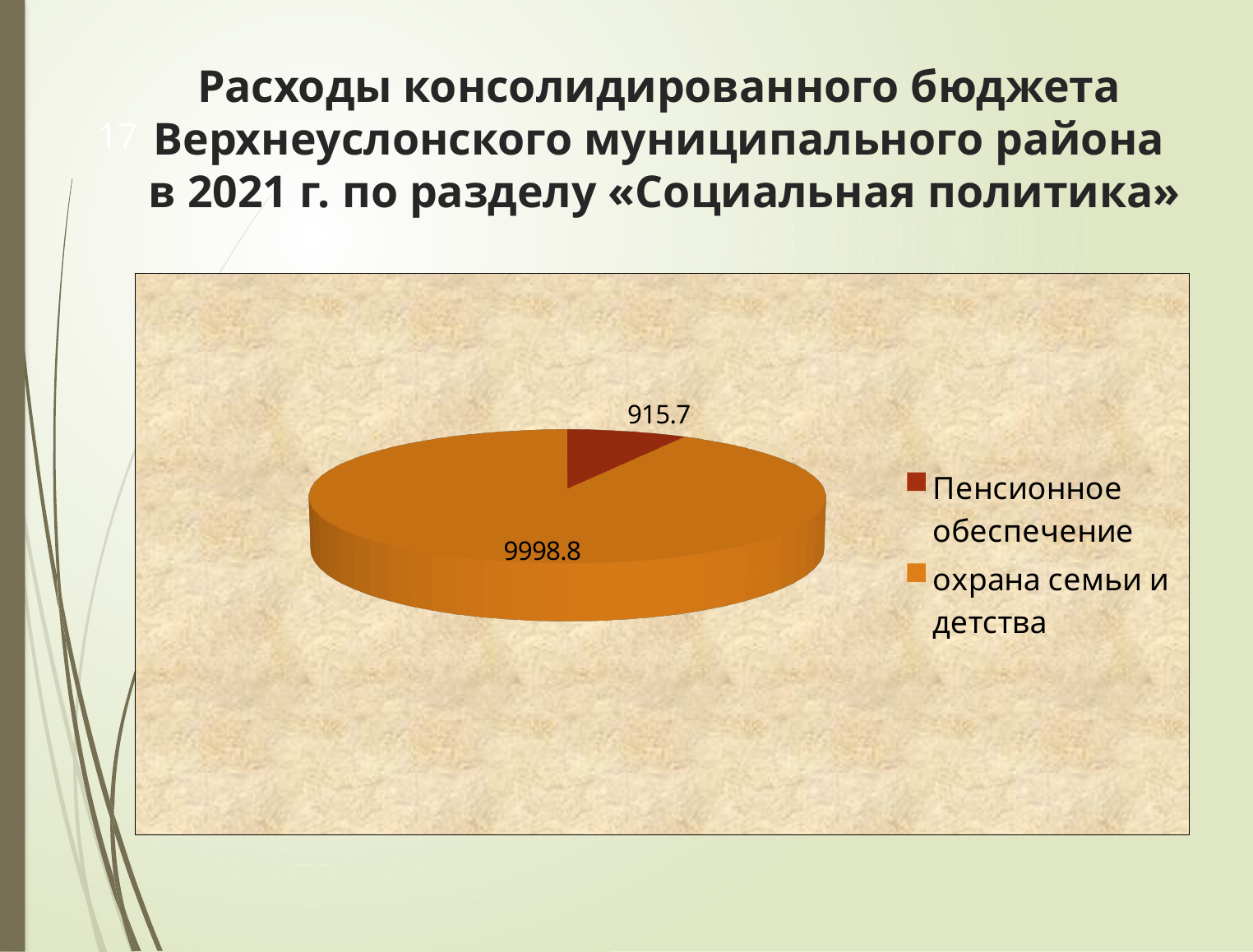
What is the value for Пенсионное обеспечение? 915.7 Which category has the smallest slice of the pie? Пенсионное обеспечение What is the difference between the values for охрана семьи и детства and Пенсионное обеспечение? 9083.1 Which is larger: the value for Пенсионное обеспечение or the value for охрана семьи и детства? охрана семьи и детства What is the total of the two values shown in the pie chart? 10914.5 How many slices does the pie chart have? 2 What kind of chart is shown on the slide? pie chart What is the value for охрана семьи и детства? 9998.8 Which category has the largest slice of the pie? охрана семьи и детства Which colour represents Пенсионное обеспечение in the pie chart? dark red How many entries does the legend list? 2